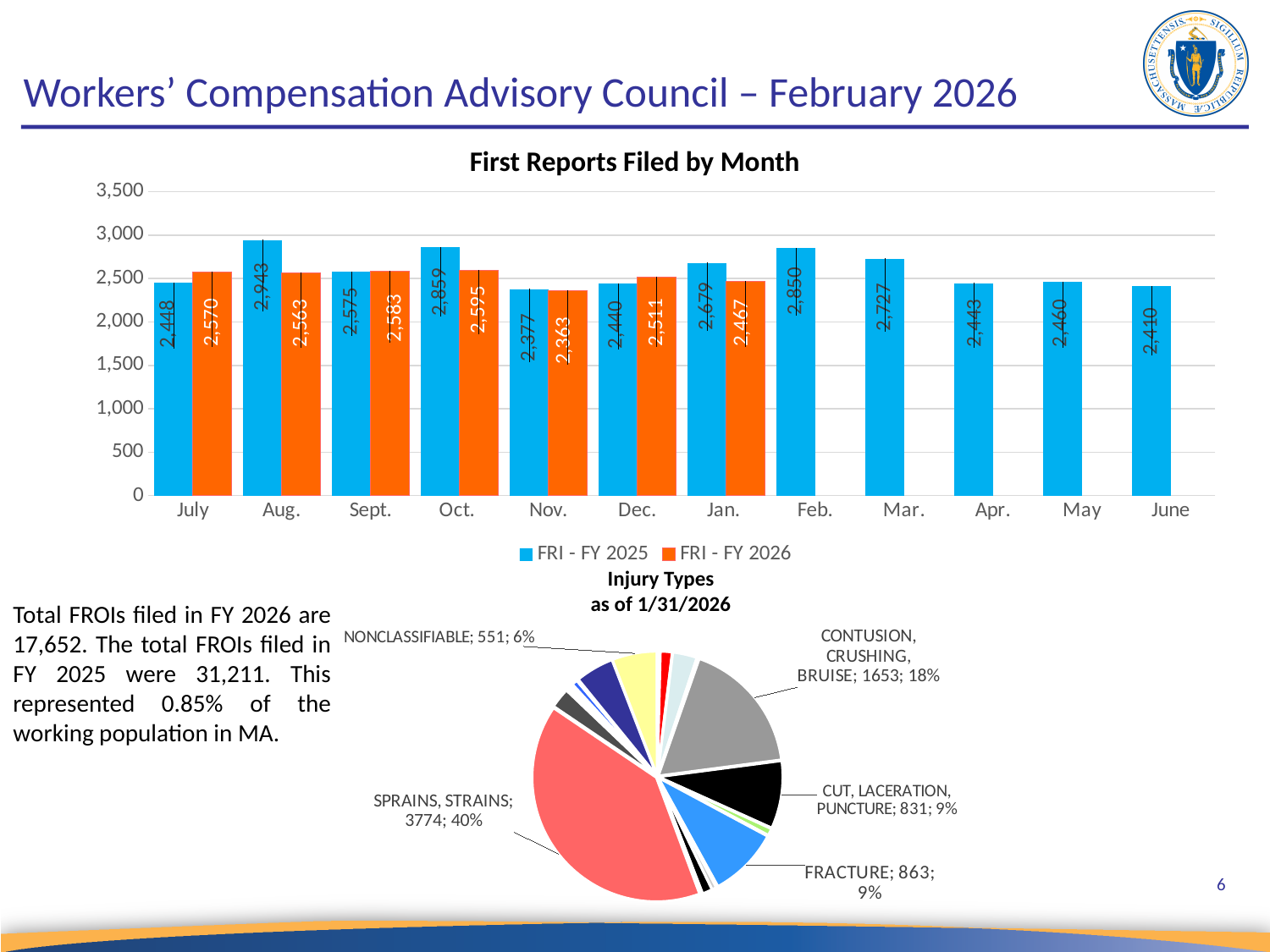
In the 'Injury Types as of 1/31/2026' pie chart, which is larger: FRACTURE or CUT, LACERATION, PUNCTURE? FRACTURE In the 'First Reports Filed by Month' chart, how many series does the legend list? 2 In the 'First Reports Filed by Month' chart, what is the FRI - FY 2025 value for February? 2,850 In the 'First Reports Filed by Month' chart, which month has the lowest FRI - FY 2026 value? Nov. In the 'First Reports Filed by Month' chart, what is the difference between the FRI - FY 2025 and FRI - FY 2026 values for August? 380 In the 'First Reports Filed by Month' chart, which is larger for December: FRI - FY 2025 or FRI - FY 2026? FRI - FY 2026 In the 'Injury Types as of 1/31/2026' pie chart, what share does SPRAINS, STRAINS represent? 40% What kind of chart is 'First Reports Filed by Month'? Bar chart In the 'Injury Types as of 1/31/2026' pie chart, what is the value for CONTUSION, CRUSHING, BRUISE? 1653 In the 'First Reports Filed by Month' chart, what is the FRI - FY 2026 value for July? 2,570 In the 'First Reports Filed by Month' chart, how many months have an FRI - FY 2026 bar? 7 In the 'First Reports Filed by Month' chart, which month has the highest FRI - FY 2025 value? Aug.